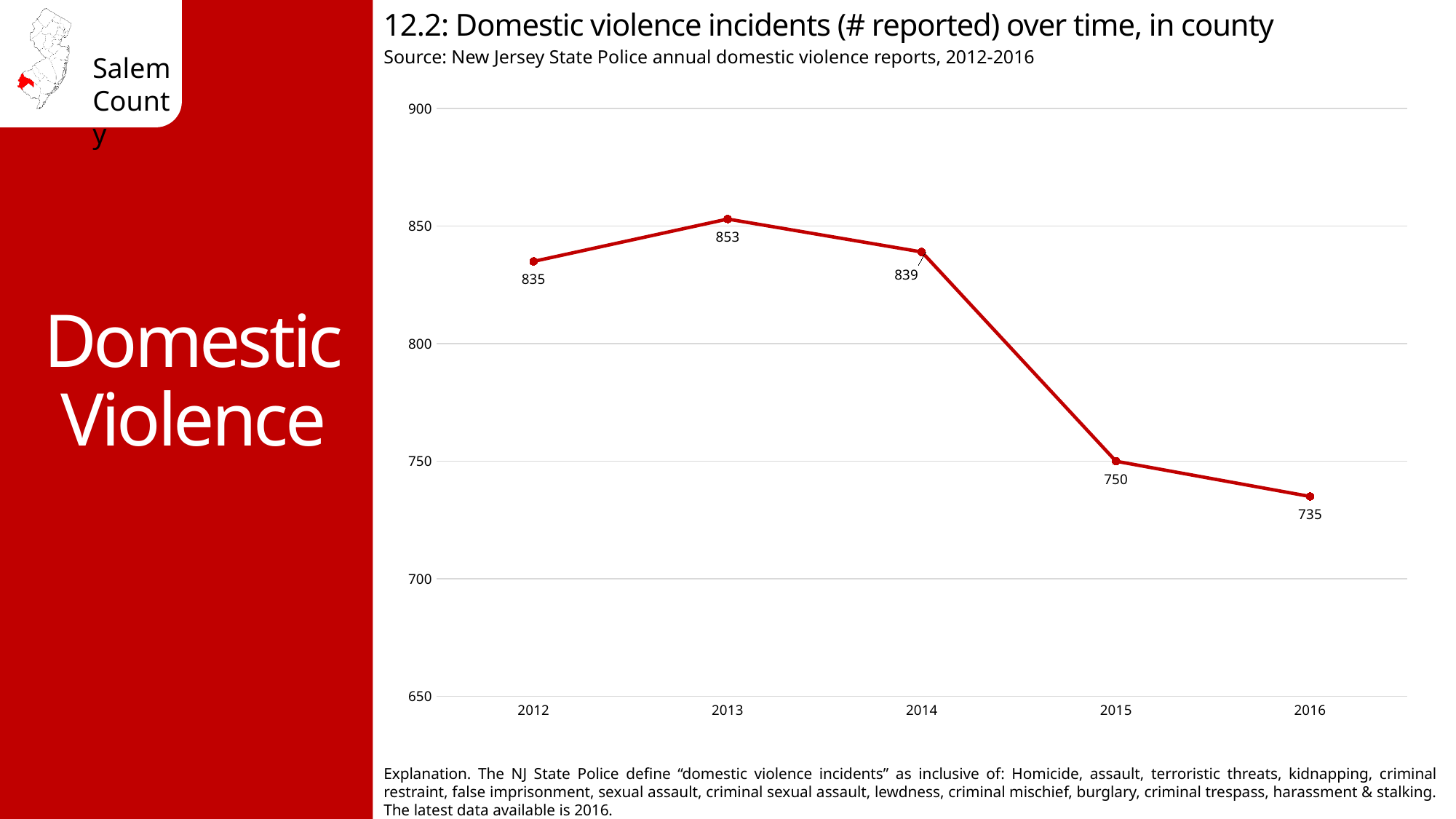
What is the difference between the number of incidents in 2013 and 2016? 118 Which year had the highest number of reported domestic violence incidents? 2013 How many domestic violence incidents were reported in 2016? 735 What type of chart is shown on the slide? line chart How many years are plotted on the chart? 5 Is the value for 2015 greater or less than 800? less Which year had more reported incidents, 2012 or 2014? 2014 Which year had the lowest number of reported domestic violence incidents? 2016 What is the difference between the number of incidents in 2014 and 2015? 89 How many domestic violence incidents were reported in 2012? 835 What is the overall trend in reported incidents from 2013 to 2016? falling How many domestic violence incidents were reported in 2013? 853